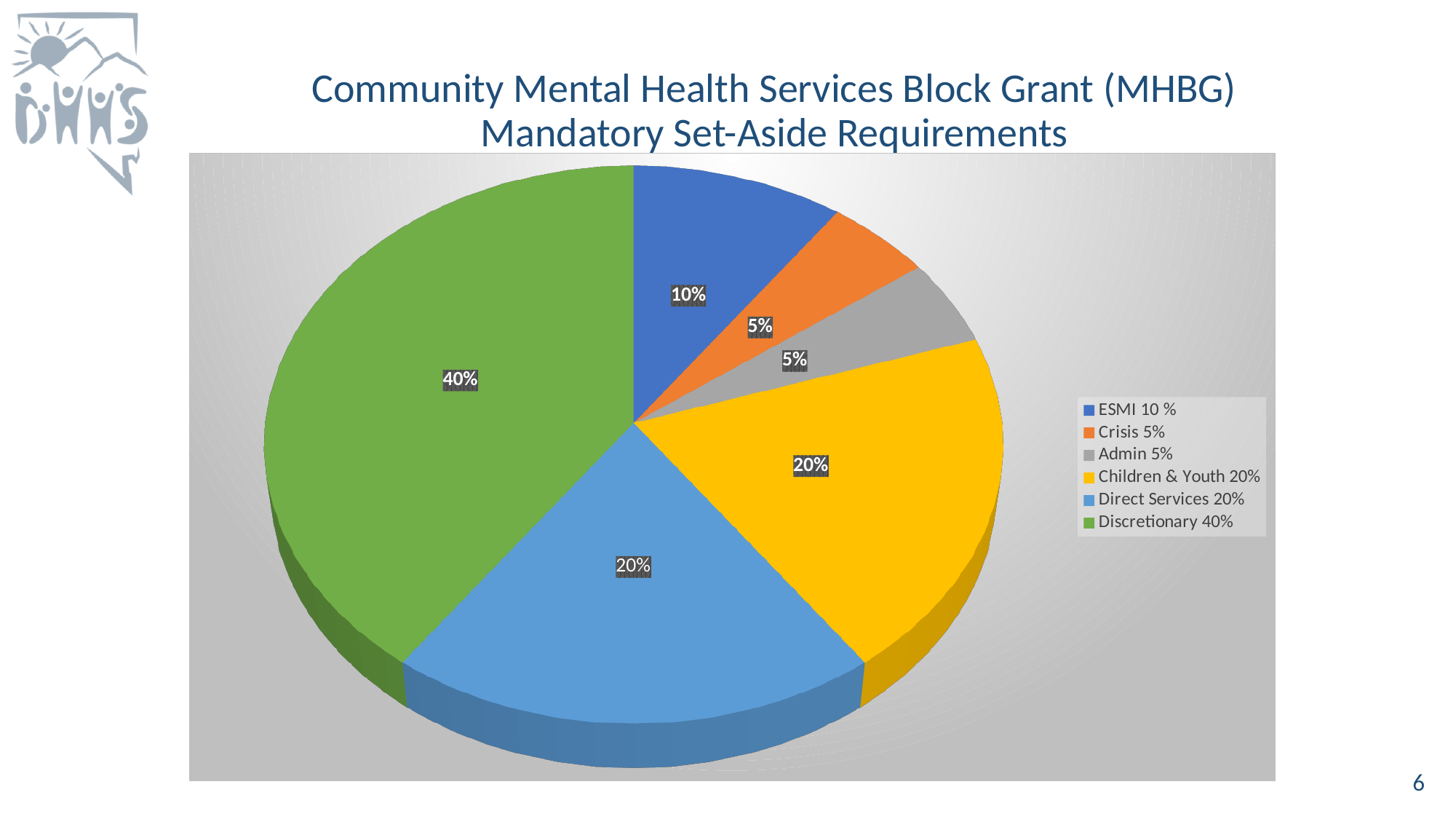
What is the value shown for Children & Youth? 20% What is the value shown for ESMI? 10% Which category has the largest slice of the pie? Discretionary What is the title of the chart? Community Mental Health Services Block Grant (MHBG) Mandatory Set-Aside Requirements What is the difference between the ESMI share and the Crisis share? 5% How many categories does the legend list? 6 What colour is the Children & Youth slice? yellow What kind of chart is shown on the slide? pie chart What is the value shown for Crisis? 5% Which is larger, the ESMI slice or the Admin slice? ESMI What share of the pie does Discretionary represent? 40% What is the difference between the Discretionary share and the Direct Services share? 20%